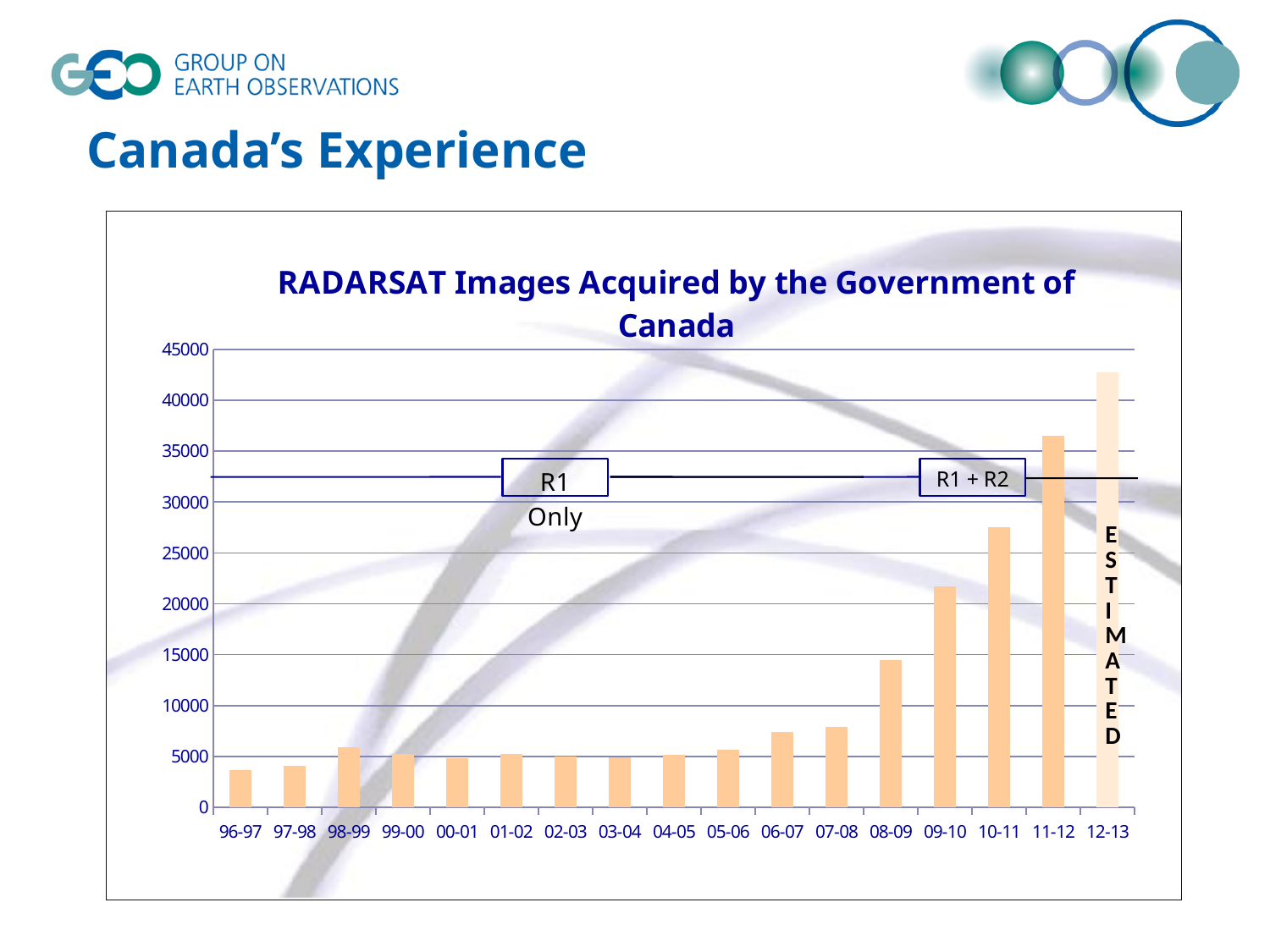
Which fiscal year has the highest number of RADARSAT images acquired? 12-13 Which fiscal year has the lowest number of RADARSAT images acquired? 96-97 Is the value for 08-09 greater or less than 15000? less What is the title of the chart? RADARSAT Images Acquired by the Government of Canada Is the value for 11-12 greater or less than 35000? greater What type of chart is shown on the slide? bar chart Which is larger, the value for 10-11 or the value for 11-12? 11-12 How many fiscal-year categories are shown on the x axis? 17 Which bar on the chart is marked as estimated? 12-13 Is the value for 12-13 greater or less than 40000? greater